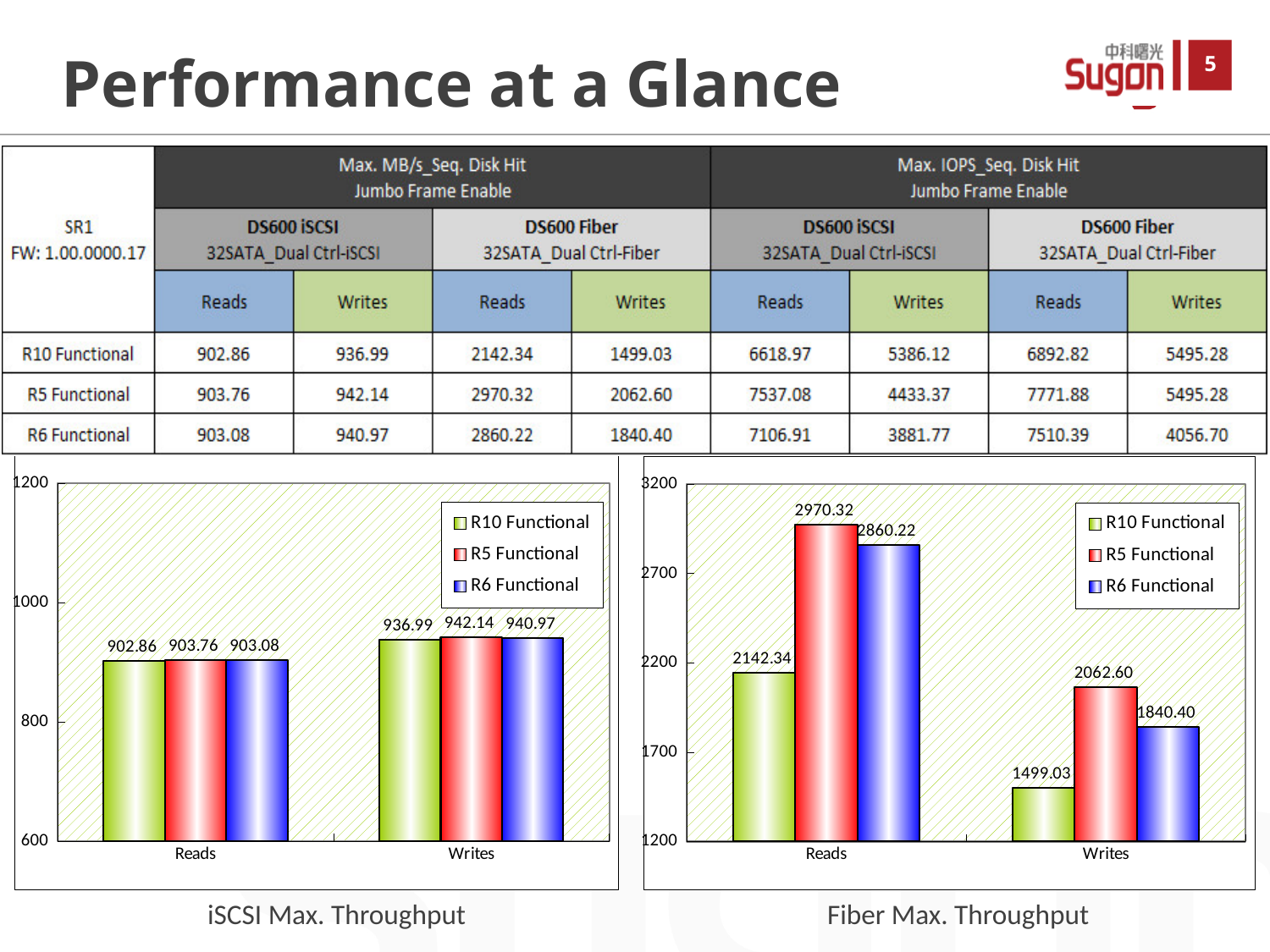
In the Fiber Max. Throughput chart, which is larger: the R5 Functional value for Writes or the R6 Functional value for Writes? R5 Functional In the Fiber Max. Throughput chart, what is the value for R10 Functional in the Writes category? 1499.03 How many series does the legend of the iSCSI Max. Throughput chart list? 3 In the Fiber Max. Throughput chart, what is the difference between the R5 Functional and R10 Functional values in the Reads category? 827.98 In the iSCSI Max. Throughput chart, what is the value for R10 Functional in the Reads category? 902.86 How many categories are shown on the x axis of the Fiber Max. Throughput chart? 2 In the Fiber Max. Throughput chart, which series has the lowest value in the Writes category? R10 Functional In the Fiber Max. Throughput chart, which series has the highest value in the Reads category? R5 Functional In the Fiber Max. Throughput chart, is the value for R10 Functional in the Reads category greater or less than 2200? less In the Fiber Max. Throughput chart, what is the value for R6 Functional in the Reads category? 2860.22 In the iSCSI Max. Throughput chart, what is the value for R5 Functional in the Writes category? 942.14 What kind of chart is the iSCSI Max. Throughput chart? Bar chart